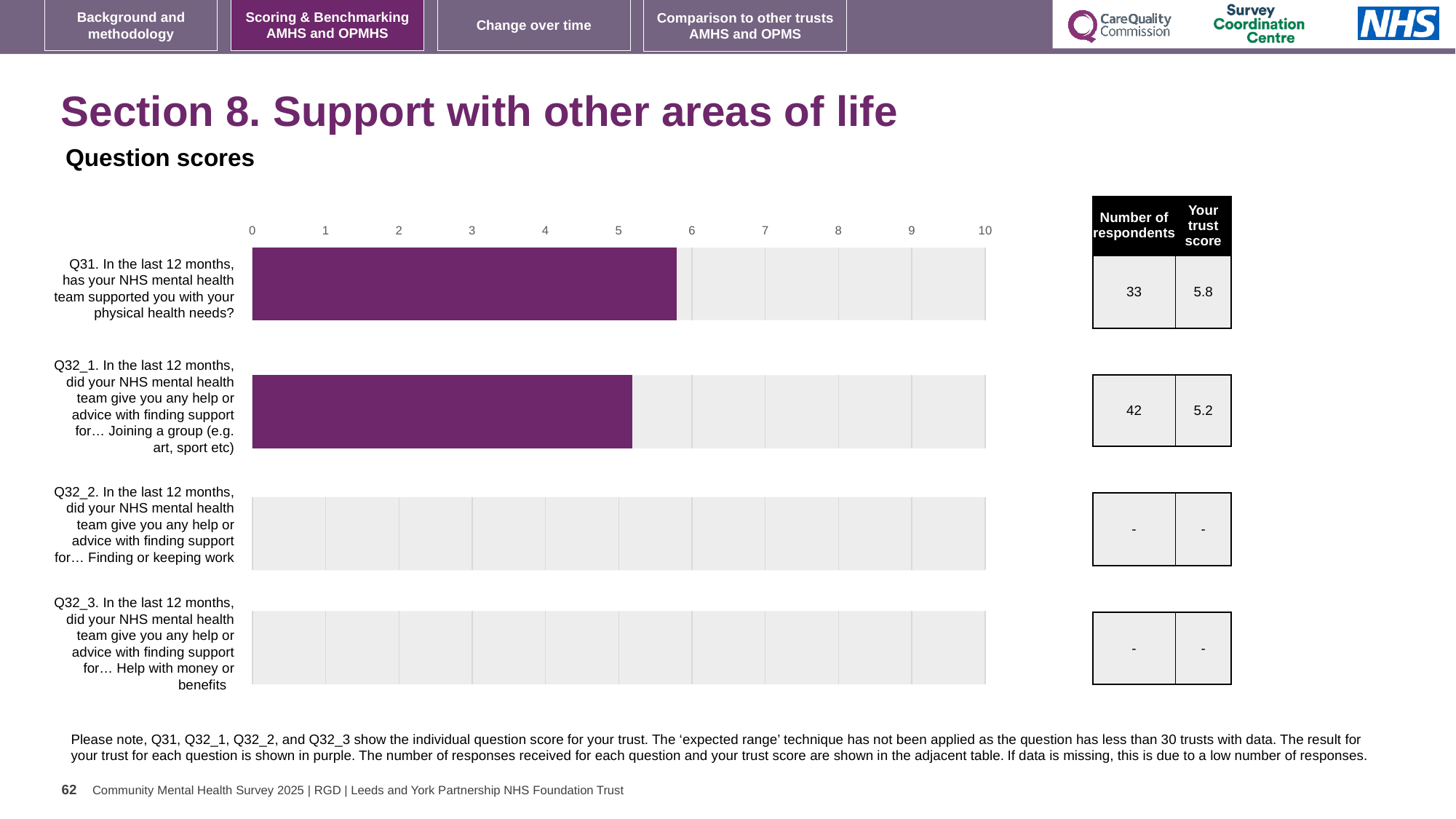
What type of chart is shown on the slide? Bar chart How many questions are listed on the chart? 4 Which has the larger trust score, Q31 or Q32_1? Q31 Which question has the highest trust score shown on the chart? Q31 How many respondents answered Q32_1? 42 What is the trust score for Q32_1 (help or advice with joining a group)? 5.2 What is the trust score for Q31 (support with physical health needs)? 5.8 Is the trust score for Q31 greater or less than 5? greater What is the difference between the trust scores for Q31 and Q32_1? 0.6 Is the trust score for Q32_1 greater or less than 6? less How many respondents answered Q31? 33 What is the maximum value shown on the chart's axis? 10